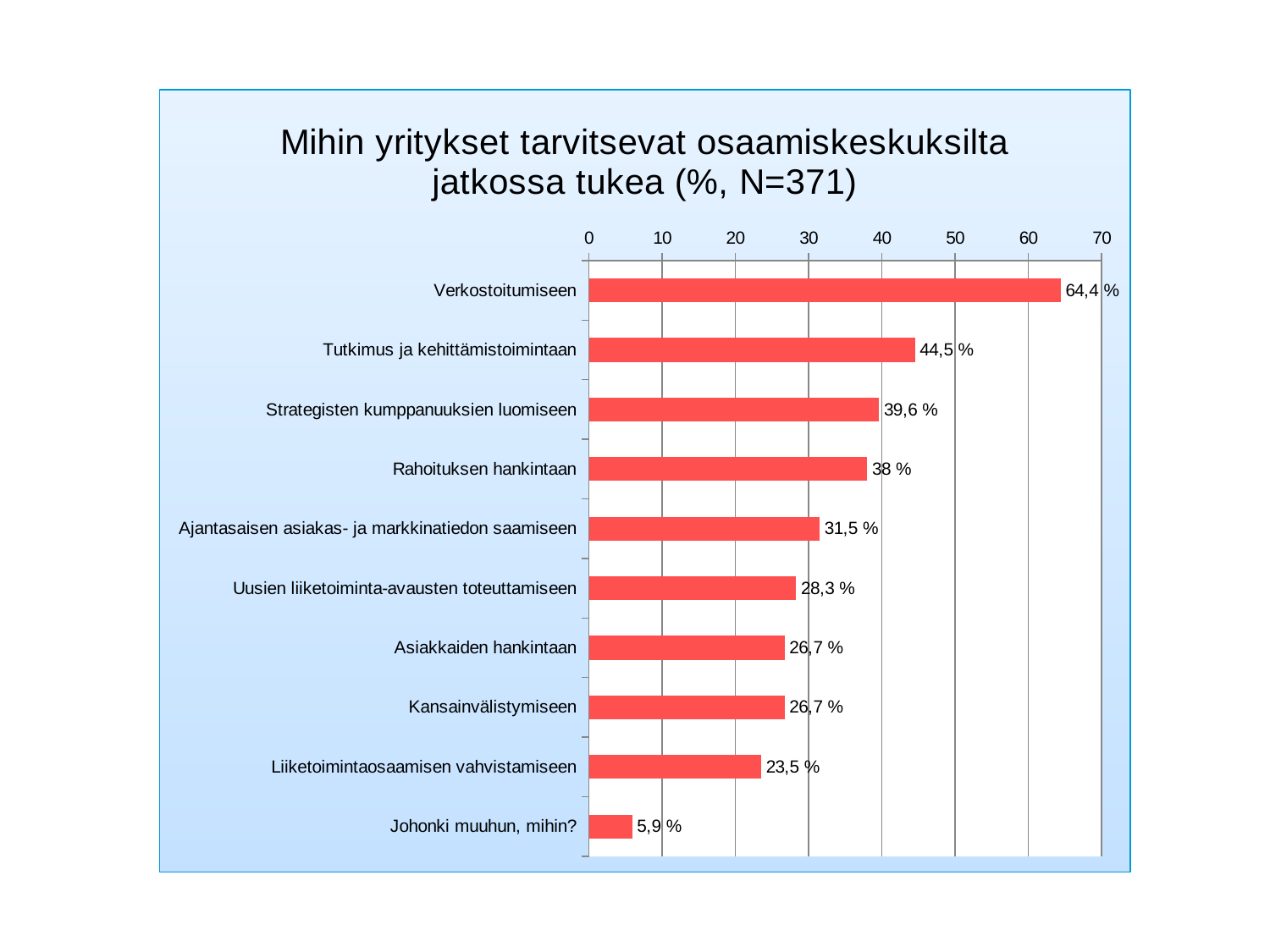
Is the value for Tutkimus ja kehittämistoimintaan greater or less than 40? greater Which category has the highest value? Verkostoitumiseen What is the difference between the values for Verkostoitumiseen and Tutkimus ja kehittämistoimintaan? 19,9 % What is the difference between the values for Rahoituksen hankintaan and Ajantasaisen asiakas- ja markkinatiedon saamiseen? 6,5 % What is the value for Liiketoimintaosaamisen vahvistamiseen? 23,5 % What is the value for Verkostoitumiseen? 64,4 % What kind of chart is shown on the slide? bar chart What is the value for Rahoituksen hankintaan? 38 % How many categories are shown in the chart? 10 Which category has the lowest value? Johonki muuhun, mihin? Which is larger, the value for Strategisten kumppanuuksien luomiseen or the value for Uusien liiketoiminta-avausten toteuttamiseen? Strategisten kumppanuuksien luomiseen What is the N value given in the chart title? 371